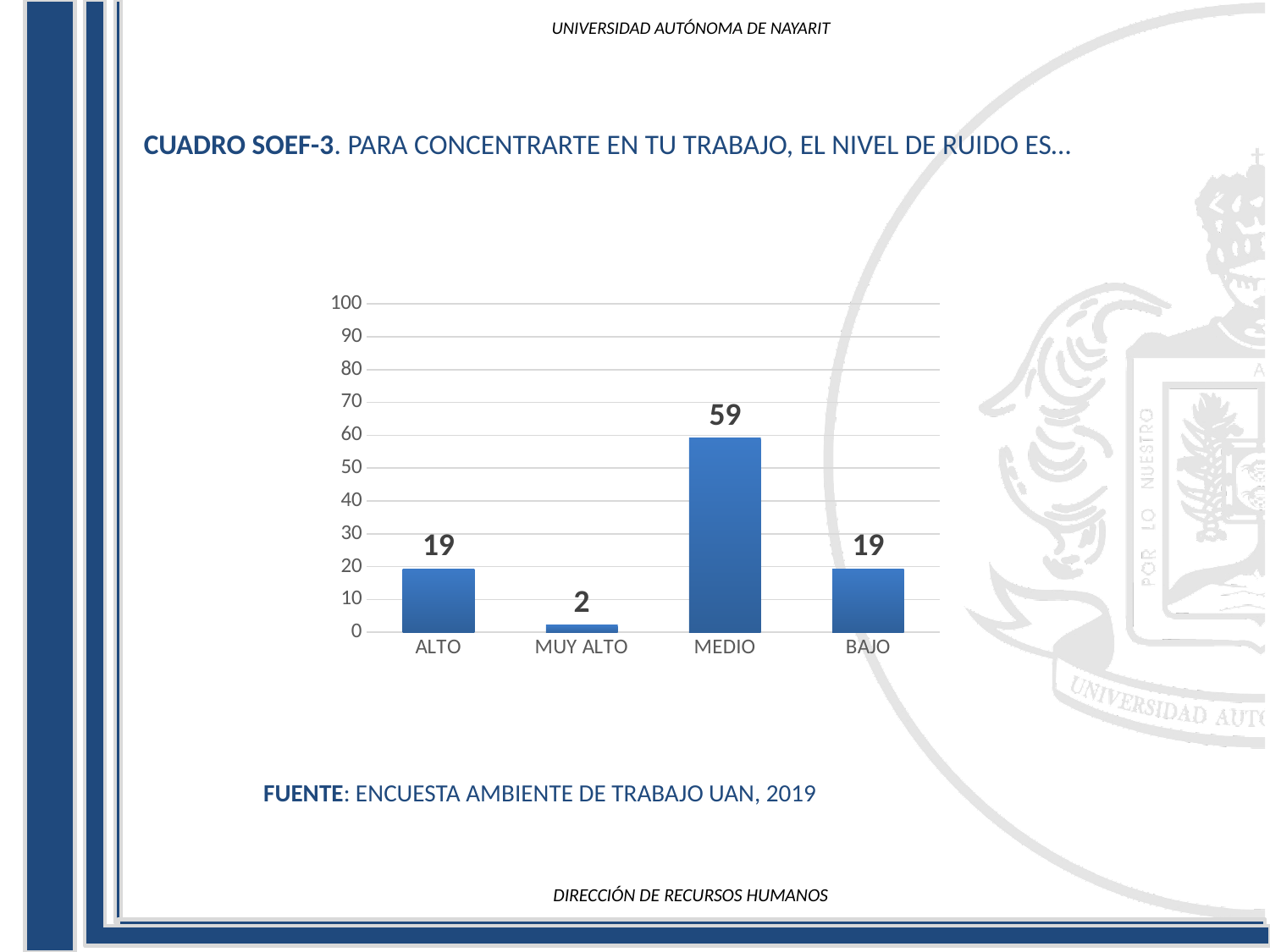
Which category has the lowest value? MUY ALTO Is the value for MEDIO greater or less than 50? greater What kind of chart is shown on the slide? bar chart What is the value for MUY ALTO? 2 How many categories are shown on the x axis? 4 What is the value for ALTO? 19 What is the difference between the values for MEDIO and ALTO? 40 What is the difference between the values for BAJO and MUY ALTO? 17 What is the value for MEDIO? 59 What is the value for BAJO? 19 Which category has the highest value? MEDIO Which is larger, the value for MEDIO or the value for BAJO? MEDIO